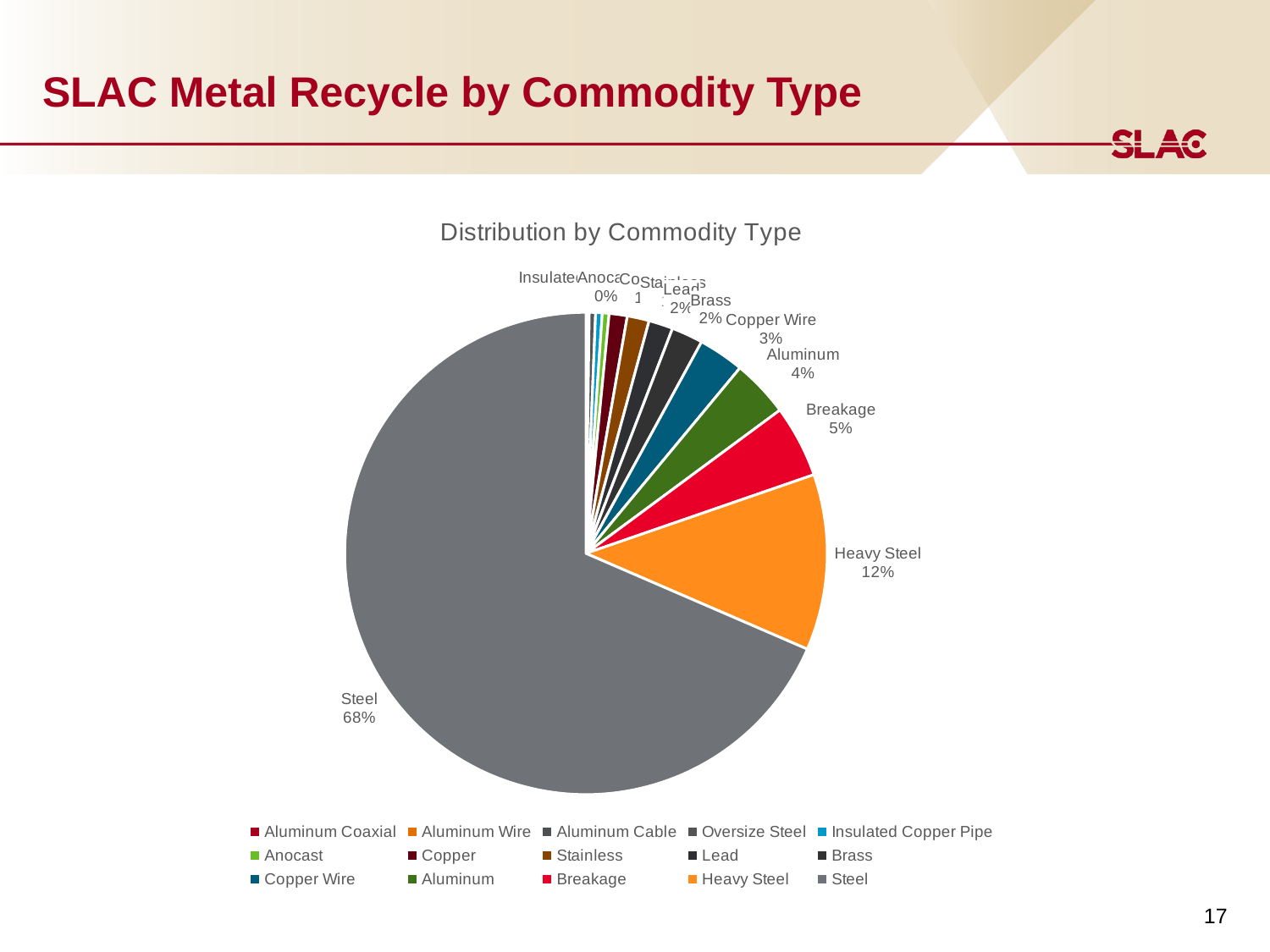
What share of the pie does Heavy Steel account for? 12% How many percentage points larger is the Steel share than the Heavy Steel share? 56 percentage points What percentage is shown for Aluminum? 4% What percentage is shown for Copper Wire? 3% Which has a larger share, Breakage or Aluminum? Breakage What kind of chart is shown on the slide? Pie chart What percentage is shown for Breakage? 5% What colour is the Heavy Steel slice? Orange How many commodity types are listed in the legend? 15 Which commodity type has the largest slice of the pie? Steel What is the title of the chart? Distribution by Commodity Type What share of the pie does Steel account for? 68%